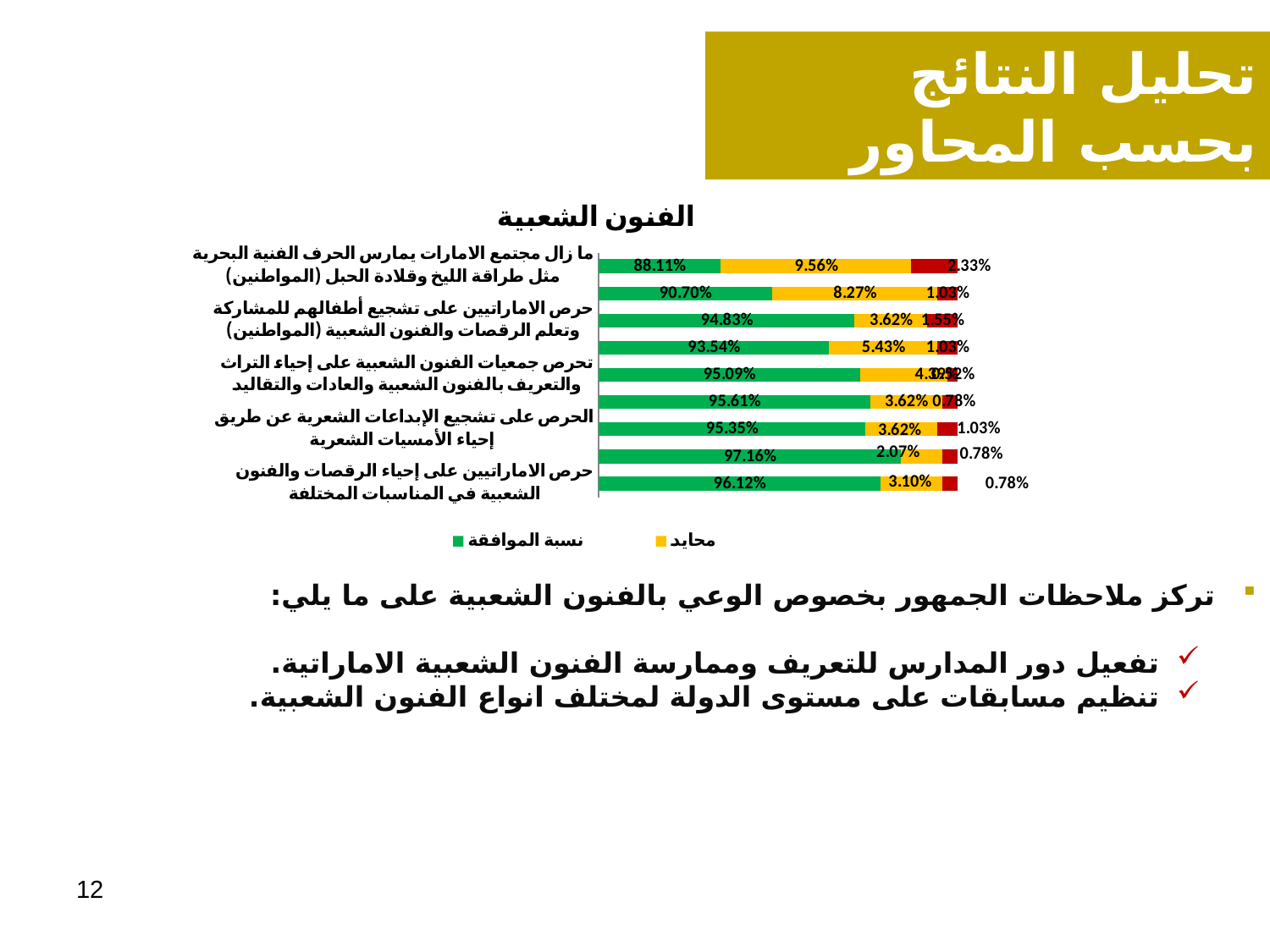
In the الفنون الشعبية chart, what is the highest نسبة الموافقة value shown on any bar? 97.16% In the الفنون الشعبية chart, which colour represents نسبة الموافقة in the legend? Green In the الفنون الشعبية chart, what is the difference between the نسبة الموافقة values of the bottom bar (96.12%) and the top bar (88.11%)? 8.01 percentage points In the الفنون الشعبية chart, what is the lowest نسبة الموافقة value shown on any bar? 88.11% In the الفنون الشعبية chart, what is the نسبة الموافقة value for the top bar, 'ما زال مجتمع الامارات يمارس الحرف الفنية البحرية مثل طراقة الليخ وقلادة الحبل (المواطنين)'? 88.11% In the الفنون الشعبية chart, what is the نسبة الموافقة value for the bottom bar, 'حرص الاماراتيين على إحياء الرقصات والفنون الشعبية في المناسبات المختلفة'? 96.12% How many bars are plotted in the الفنون الشعبية chart? 9 In the الفنون الشعبية chart, what is the total of the three segments of the top bar (88.11%, 9.56%, 2.33%)? 100.00% In the الفنون الشعبية chart, what is the محايد value for the bottom bar, 'حرص الاماراتيين على إحياء الرقصات والفنون الشعبية في المناسبات المختلفة'? 3.10% In the الفنون الشعبية chart, which has the larger محايد value: the top bar 'ما زال مجتمع الامارات يمارس الحرف الفنية البحرية' or the bottom bar 'حرص الاماراتيين على إحياء الرقصات والفنون الشعبية'? The top bar (ما زال مجتمع الامارات يمارس الحرف الفنية البحرية) What type of chart is shown under the title الفنون الشعبية? Stacked horizontal bar chart In the الفنون الشعبية chart, what is the محايد value for the top bar, 'ما زال مجتمع الامارات يمارس الحرف الفنية البحرية'? 9.56%